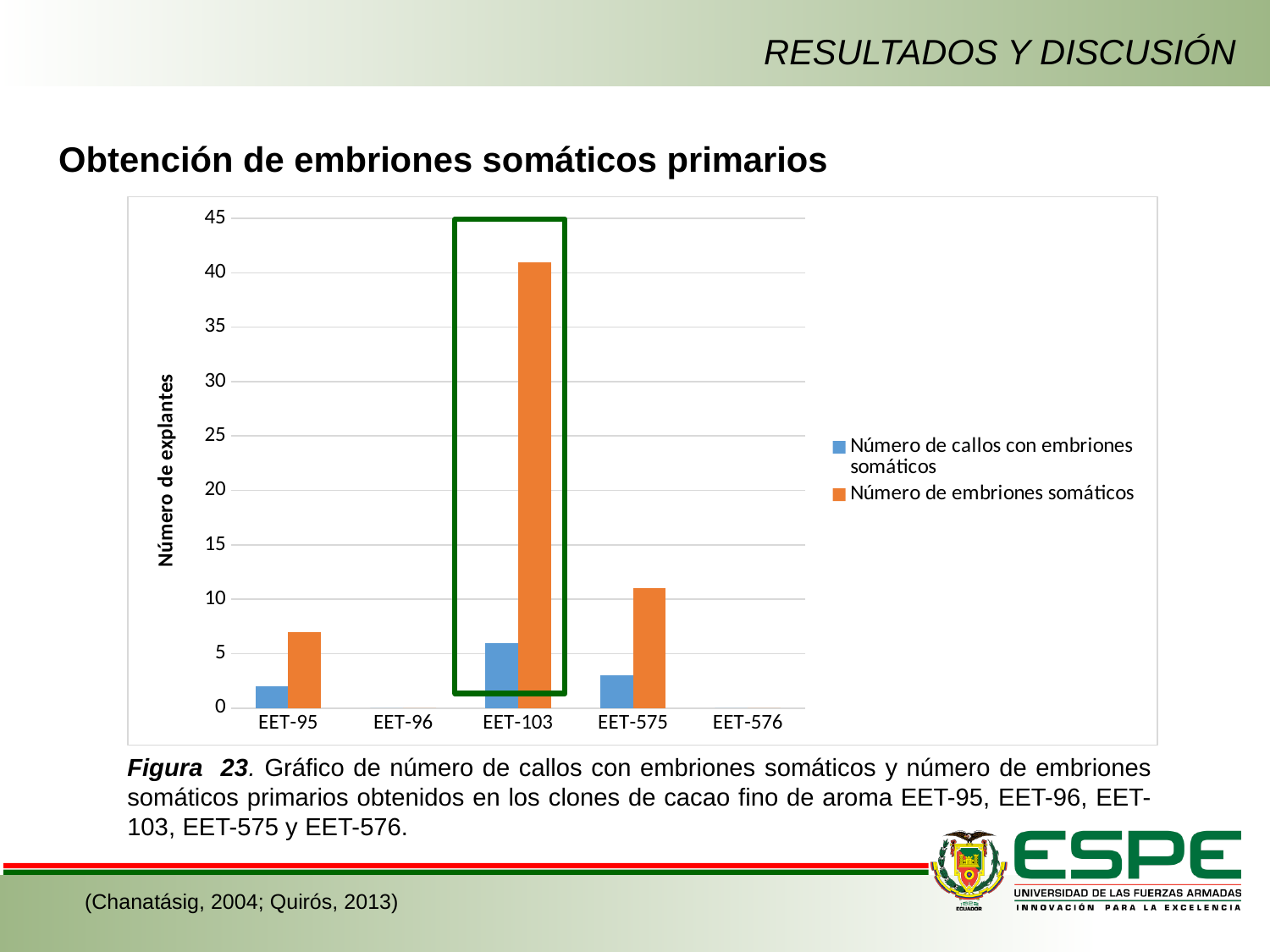
Is the value of Número de embriones somáticos for EET-103 greater or less than 35? greater How many clone categories are shown on the x axis of the chart? 5 What kind of chart is shown on the slide? bar chart Which clone has the highest value for Número de callos con embriones somáticos? EET-103 Which is larger, the Número de embriones somáticos for EET-575 or for EET-95? EET-575 Which clone has the highest value for Número de embriones somáticos? EET-103 How many series does the chart's legend list? 2 What is the title of the chart's vertical axis? Número de explantes Is the value of Número de embriones somáticos for EET-95 greater or less than 10? less Is the value of Número de callos con embriones somáticos for EET-95 greater or less than 5? less Which is larger, the Número de callos con embriones somáticos for EET-103 or for EET-575? EET-103